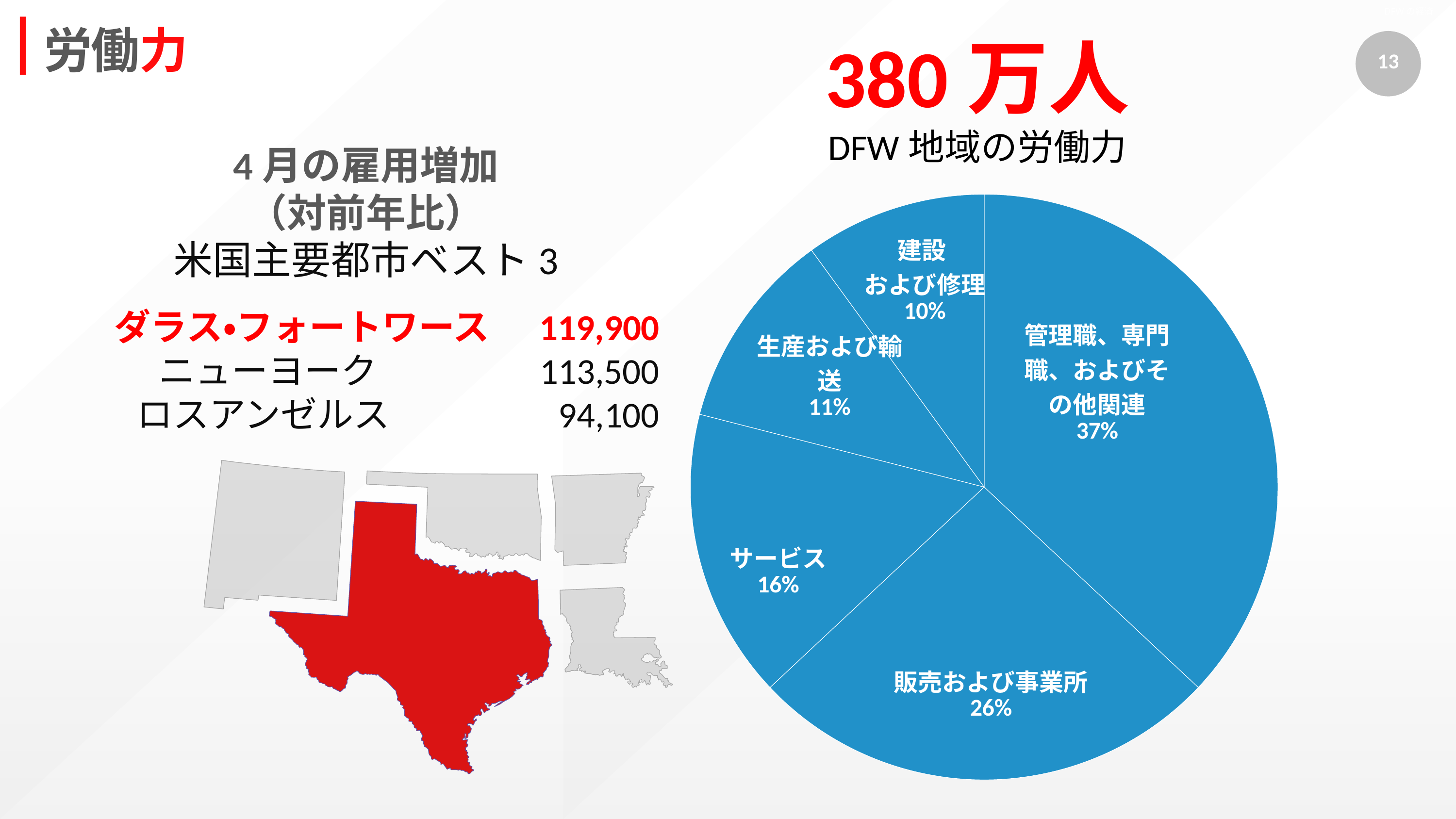
What is the difference in percentage points between 販売および事業所 and サービス? 10 What share of the pie does 生産および輸送 hold? 11% Which is larger, the slice for サービス or the slice for 生産および輸送? サービス Which category has the largest slice of the pie? 管理職、専門職、およびその他関連 What share of the pie does 建設および修理 hold? 10% How many slices does the pie chart have? 5 What kind of chart is shown on the slide? pie chart What share of the pie does 管理職、専門職、およびその他関連 hold? 37% What is the title shown above the pie chart? DFW 地域の労働力 Which category has the smallest slice of the pie? 建設および修理